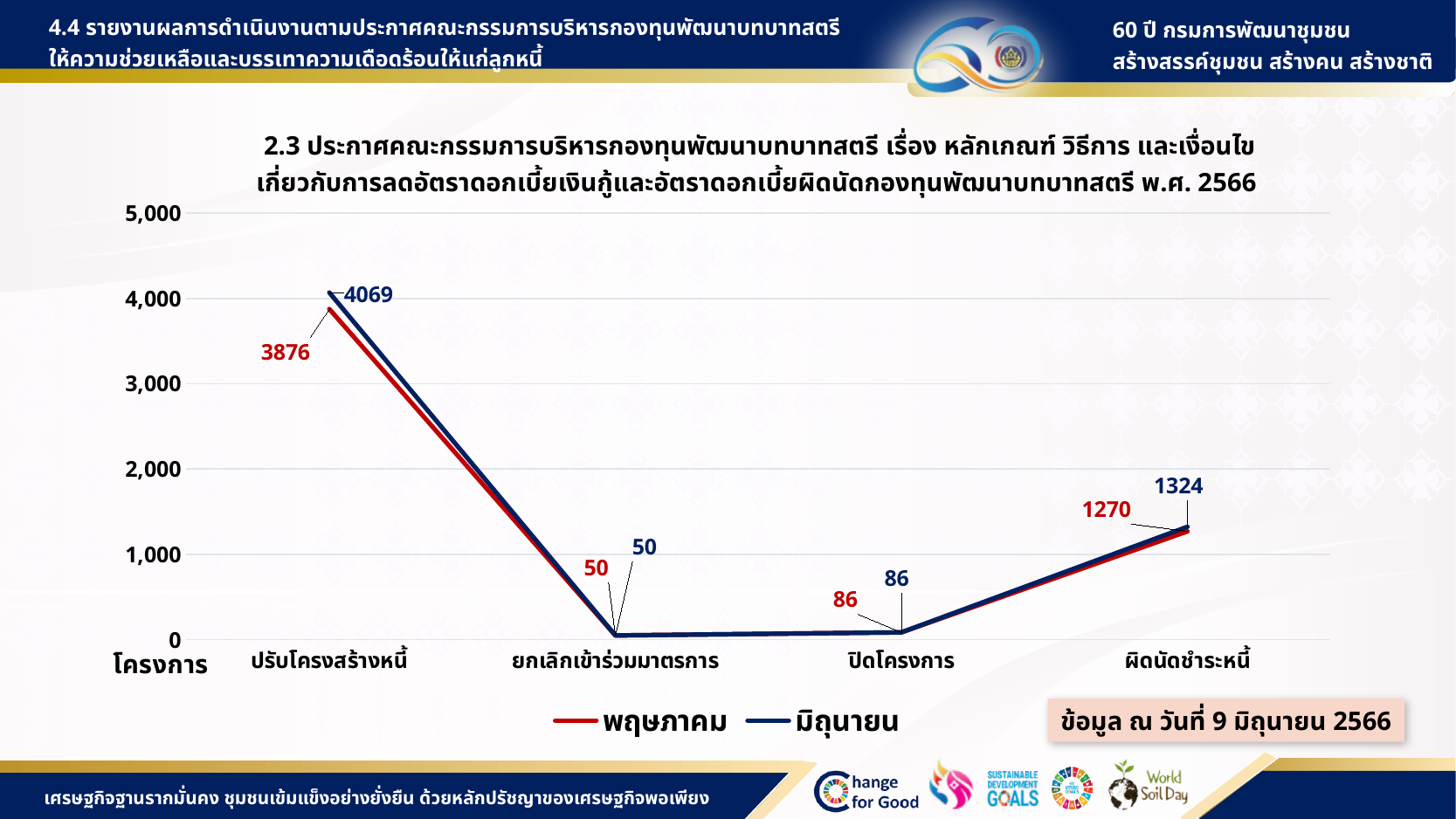
Which series is drawn in red in the legend? พฤษภาคม How many categories are shown on the x axis? 4 What is the difference between the มิถุนายน and พฤษภาคม values for ปรับโครงสร้างหนี้? 193 For ผิดนัดชำระหนี้, which series has the larger value, พฤษภาคม or มิถุนายน? มิถุนายน What kind of chart is shown on the slide? line chart What is the value for ผิดนัดชำระหนี้ in the มิถุนายน series? 1324 What is the value for ปิดโครงการ in the พฤษภาคม series? 86 Which category has the highest value in the มิถุนายน series? ปรับโครงสร้างหนี้ Which category has the lowest value in the พฤษภาคม series? ยกเลิกเข้าร่วมมาตรการ What is the value for ปรับโครงสร้างหนี้ in the พฤษภาคม series? 3876 How many series does the legend list? 2 What is the value for ปรับโครงสร้างหนี้ in the มิถุนายน series? 4069